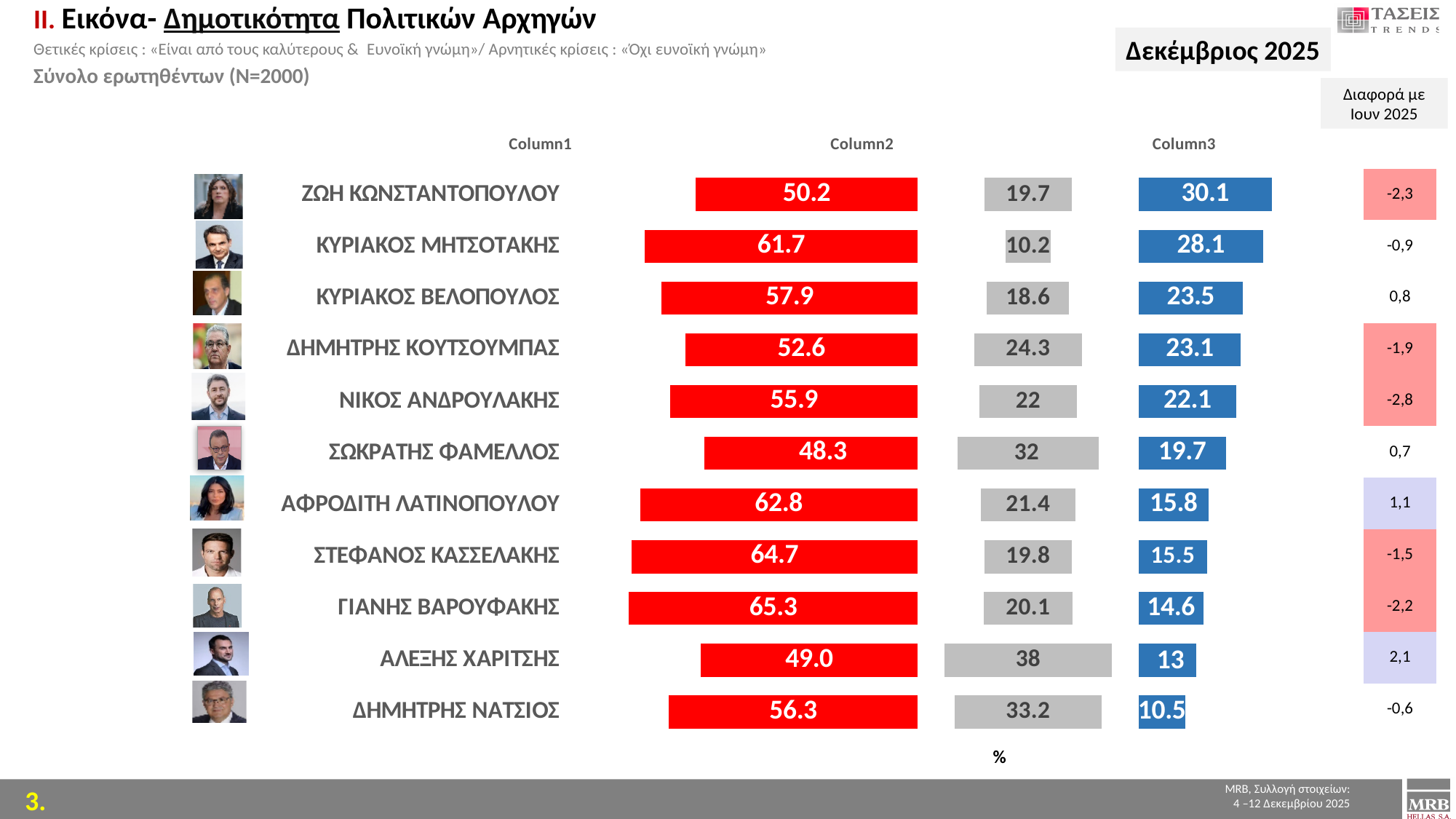
What is the Column3 value for ΖΩΗ ΚΩΝΣΤΑΝΤΟΠΟΥΛΟΥ? 30.1 What is the Column2 value for ΑΛΕΞΗΣ ΧΑΡΙΤΣΗΣ? 38 Which leader has the lowest Column3 value? ΔΗΜΗΤΡΗΣ ΝΑΤΣΙΟΣ Which is larger: the Column3 value for ΝΙΚΟΣ ΑΝΔΡΟΥΛΑΚΗΣ or for ΣΩΚΡΑΤΗΣ ΦΑΜΕΛΛΟΣ? ΝΙΚΟΣ ΑΝΔΡΟΥΛΑΚΗΣ Which leader has the lowest Column1 value? ΣΩΚΡΑΤΗΣ ΦΑΜΕΛΛΟΣ What is the Column1 value for ΚΥΡΙΑΚΟΣ ΜΗΤΣΟΤΑΚΗΣ? 61.7 What kind of chart is shown on the slide? bar chart What colour are the Column1 bars in the chart? red How many series does the chart's legend list? 3 Which leader has the highest Column1 value? ΓΙΑΝΗΣ ΒΑΡΟΥΦΑΚΗΣ How many political leaders (categories) are plotted in the chart? 11 What is the difference between the Column1 values of ΚΥΡΙΑΚΟΣ ΜΗΤΣΟΤΑΚΗΣ and ΚΥΡΙΑΚΟΣ ΒΕΛΟΠΟΥΛΟΣ? 3.8